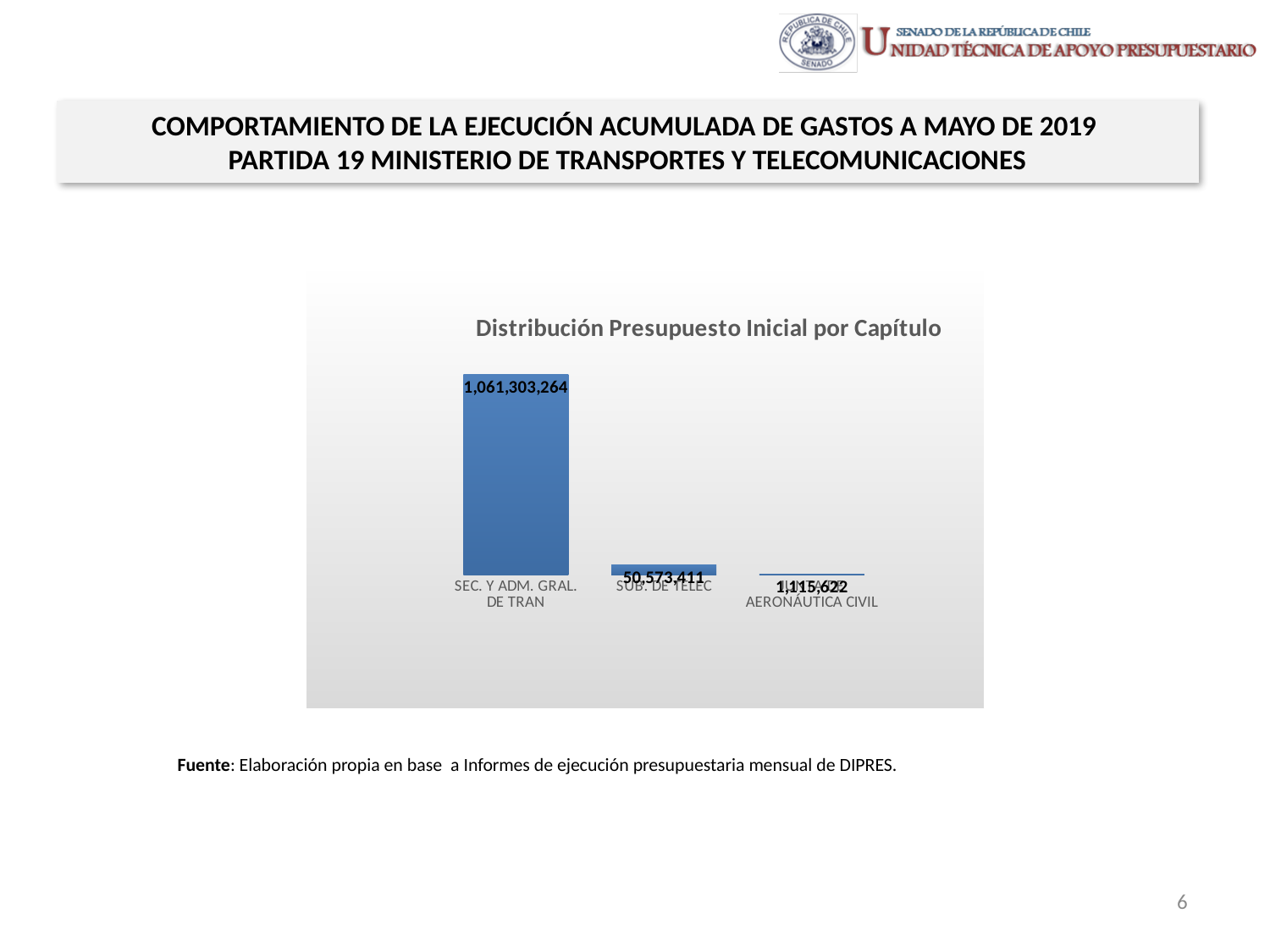
What type of chart is shown on the slide? Bar chart What is the difference between the values for SEC. Y ADM. GRAL. DE TRAN and SUB. DE TELEC? 1,010,729,853 What is the value for SUB. DE TELEC? 50,573,411 Which is larger, the value for SUB. DE TELEC or the value for AERONÁUTICA CIVIL? SUB. DE TELEC What is the title of the chart? Distribución Presupuesto Inicial por Capítulo How many categories are shown in the chart? 3 Which category has the lowest value? AERONÁUTICA CIVIL What is the difference between the values for SUB. DE TELEC and AERONÁUTICA CIVIL? 49,457,789 What is the value for AERONÁUTICA CIVIL? 1,115,622 Which category has the highest value? SEC. Y ADM. GRAL. DE TRAN Do the values rise or fall from left to right across the categories? Fall What is the value for SEC. Y ADM. GRAL. DE TRAN? 1,061,303,264